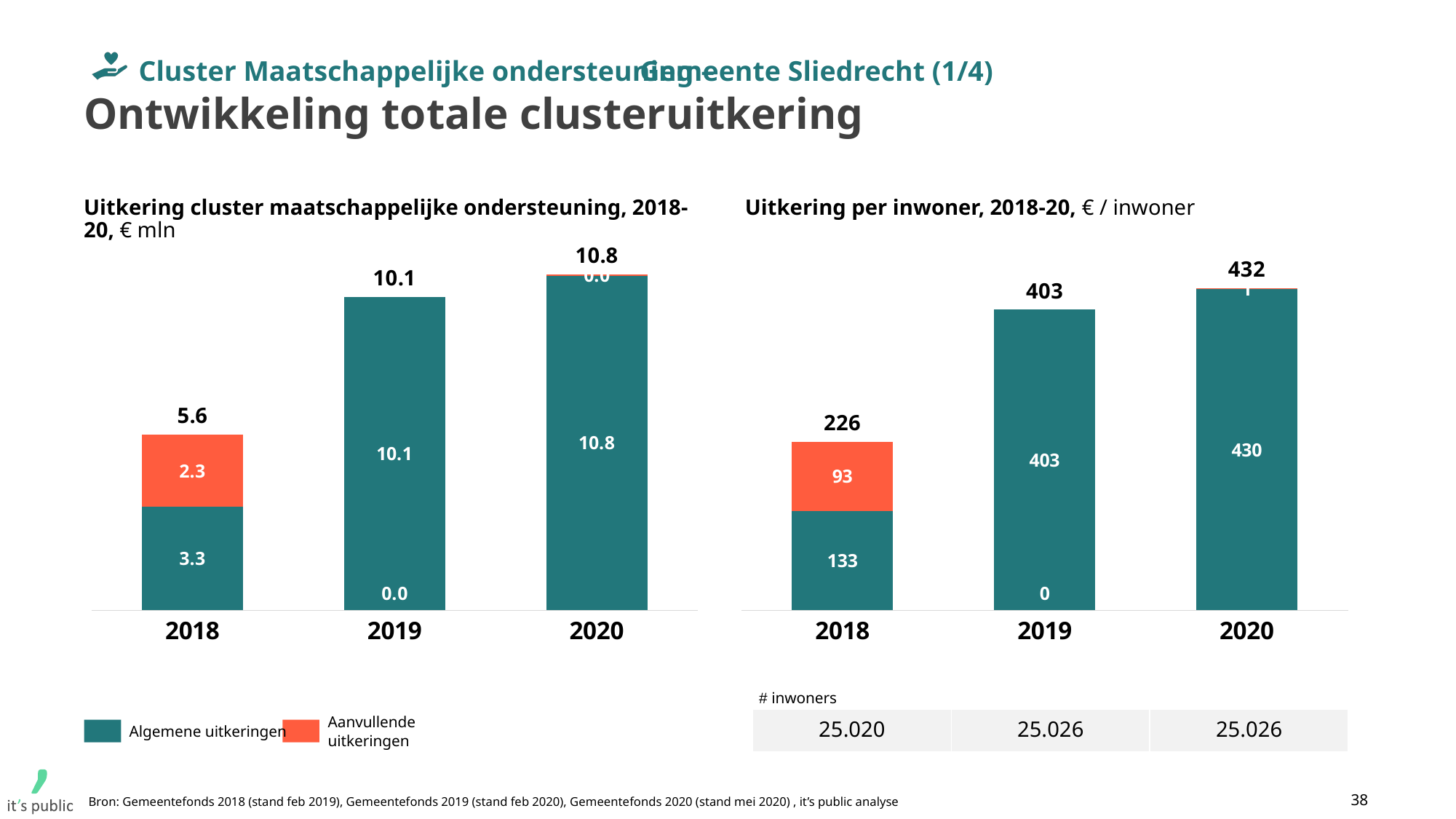
How many series does the legend list for the left chart? 2 In the right chart (Uitkering per inwoner), what is the value of Algemene uitkeringen in 2020? 430 What kind of chart is the right chart (Uitkering per inwoner)? stacked bar chart In the left chart (Uitkering cluster maatschappelijke ondersteuning), what is the total value for 2018? 5.6 In the left chart (Uitkering cluster maatschappelijke ondersteuning), what is the value of Algemene uitkeringen in 2018? 3.3 In the right chart (Uitkering per inwoner), what is the total value for 2018? 226 In the right chart (Uitkering per inwoner), which year has the lowest total? 2018 In the right chart (Uitkering per inwoner), what is the difference between the 2019 total and the 2018 total? 177 In the left chart (Uitkering cluster maatschappelijke ondersteuning), which year has the highest total? 2020 In the left chart (Uitkering cluster maatschappelijke ondersteuning), what is the difference between the 2020 total and the 2019 total? 0.7 In the left chart (Uitkering cluster maatschappelijke ondersteuning), do the totals rise or fall from 2018 to 2020? rise In the left chart (Uitkering cluster maatschappelijke ondersteuning), what is the value of Aanvullende uitkeringen in 2018? 2.3